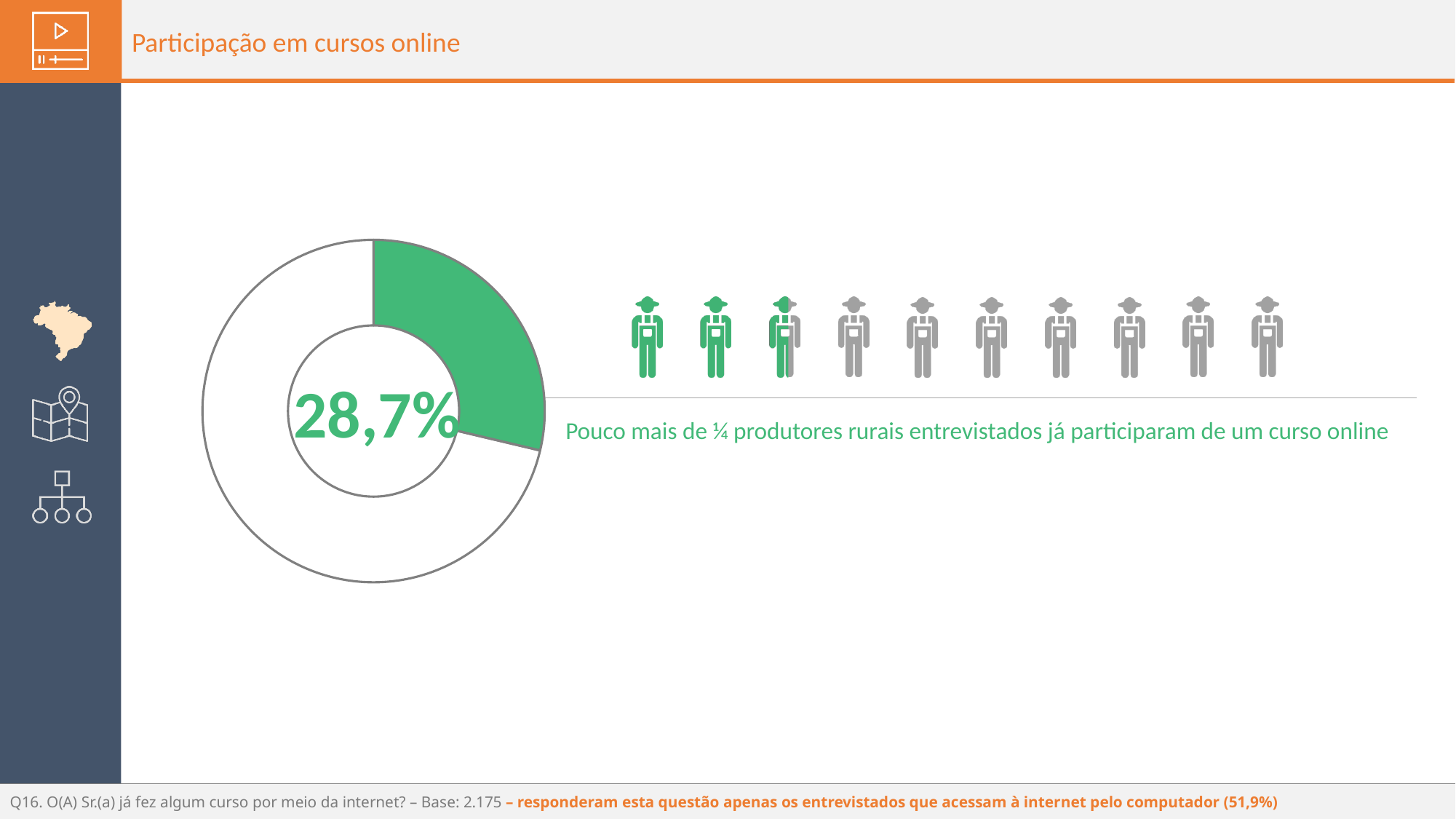
What colour is the slice representing producers who participated in an online course? Green Is the green slice of the donut chart larger or smaller than the white slice? smaller What is the title of the slide containing the donut chart? Participação em cursos online What share of the donut chart is filled in green? 28,7% How many farmer icons are shown in the pictogram to the right of the donut chart? 10 What share of the donut chart is left unfilled (white)? 71,3% What percentage is shown in the centre of the donut chart? 28,7% What kind of chart is used to show the share of rural producers who took an online course? Pie (donut) chart How many slices does the donut chart have? 2 What is the base (number of respondents) stated for the question shown on the slide? 2.175